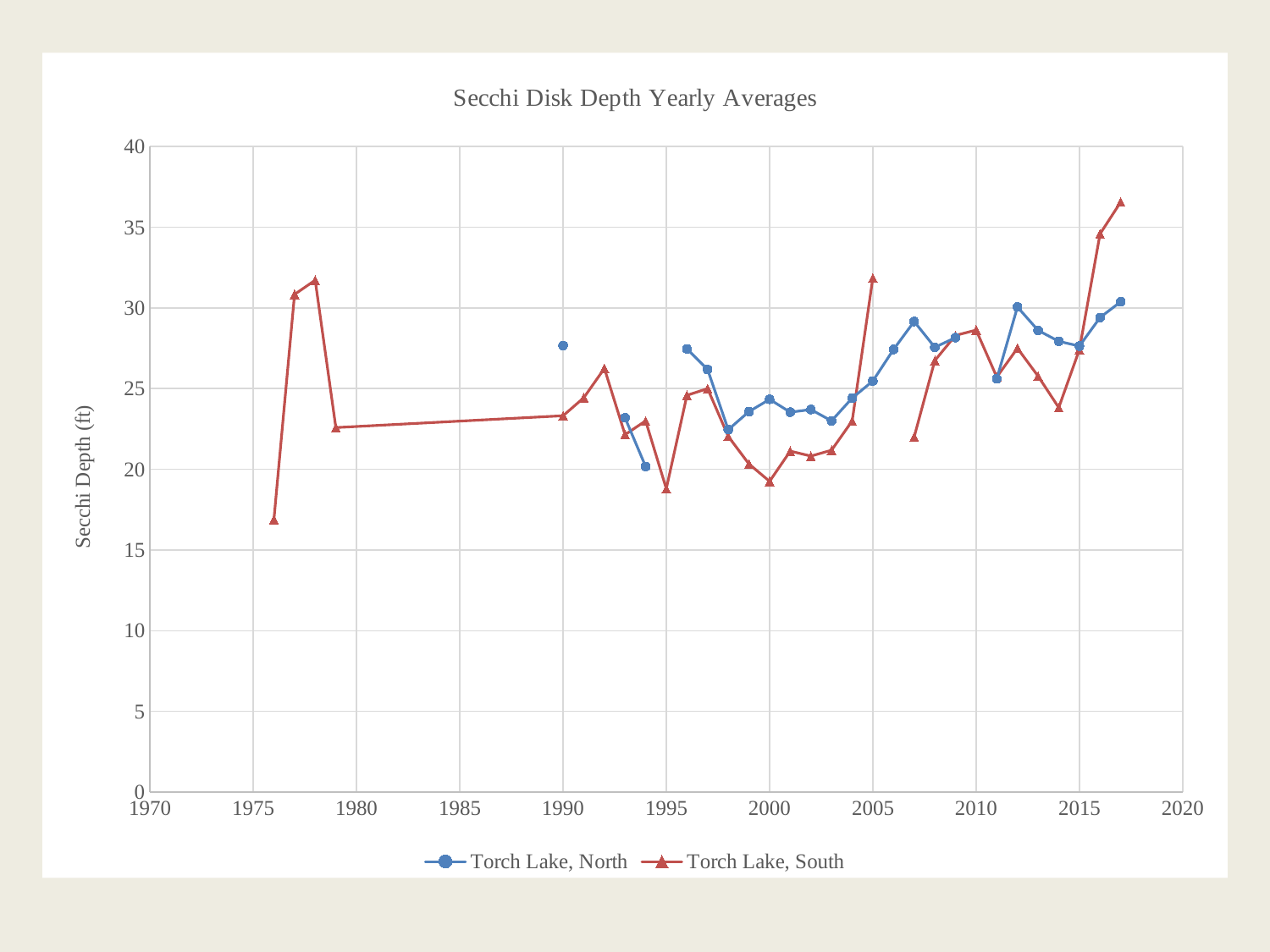
Is the value for Torch Lake, South in 1976 greater or less than 20? less Is the value for Torch Lake, South in 2017 greater or less than 35? greater How many series does the legend list? 2 Is the value for Torch Lake, North in 1990 greater or less than 25? greater What is the label on the vertical axis? Secchi Depth (ft) In which year does Torch Lake, South have its lowest value? 1976 What kind of chart is shown on the slide? Line chart In which year does Torch Lake, South reach its highest value? 2017 Does the Torch Lake, South series rise or fall from 2014 to 2017? Rise In 2007, which series has the larger value, Torch Lake, North or Torch Lake, South? Torch Lake, North What is the title of the chart? Secchi Disk Depth Yearly Averages